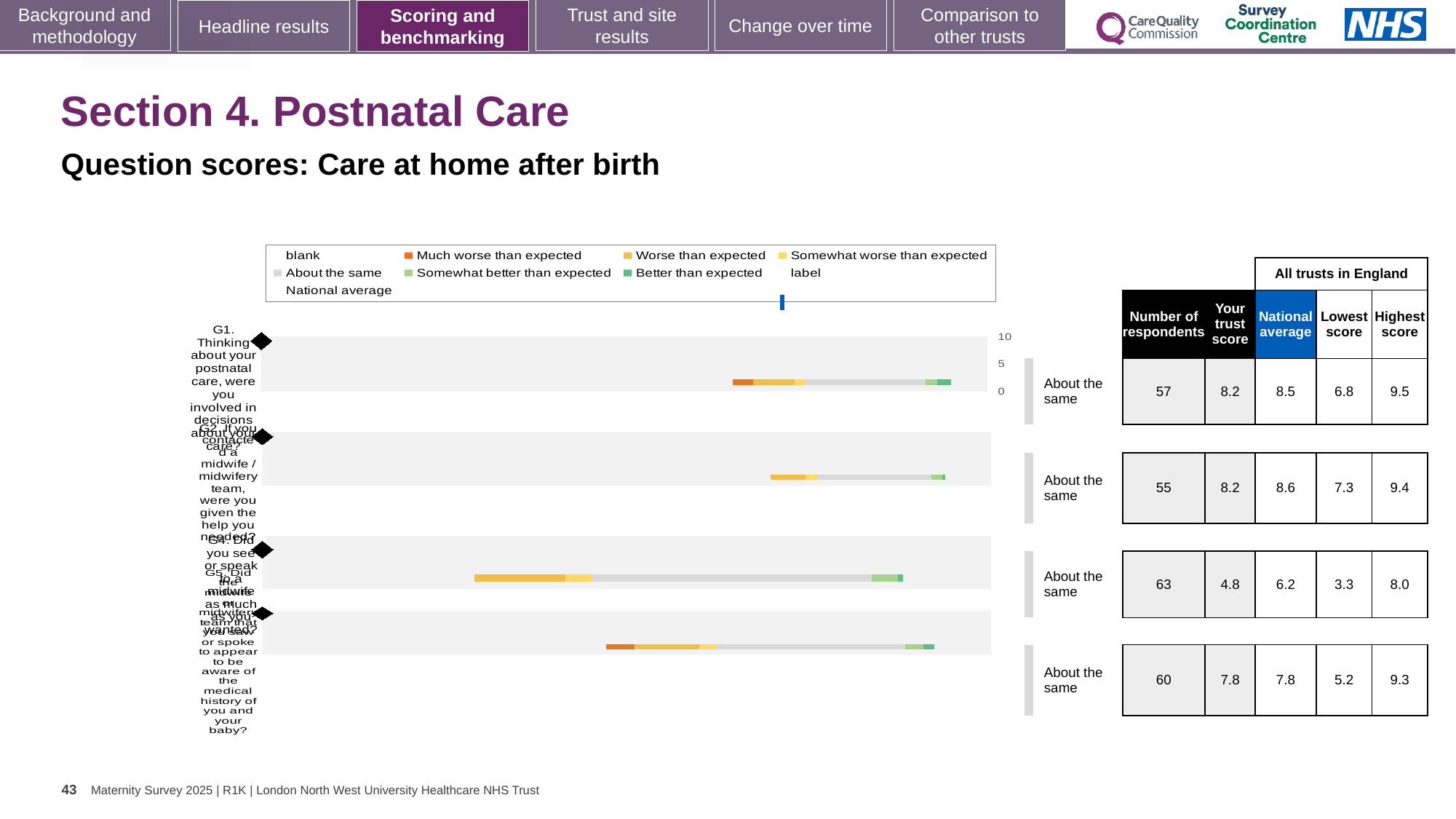
How many respondents are there for the third row of the chart? 63 What is the national average for the first row (G1)? 8.5 How many question rows (bars) does the chart show? 4 What colour does the legend use for 'Much worse than expected'? orange What is the lowest score in England for the second row (G2)? 7.3 Which row has the lowest trust score? the third row (4.8) Which is larger, the highest score for the first row or the highest score for the second row? the first row (9.5) What is the trust score for G1 (involved in decisions about your postnatal care), the first row? 8.2 What kind of chart is shown on the slide? bar chart What benchmark category is shown for the fourth row? About the same Which row has the highest number of respondents? the third row (63) For the third row, how much higher is the national average than the trust score? 1.4